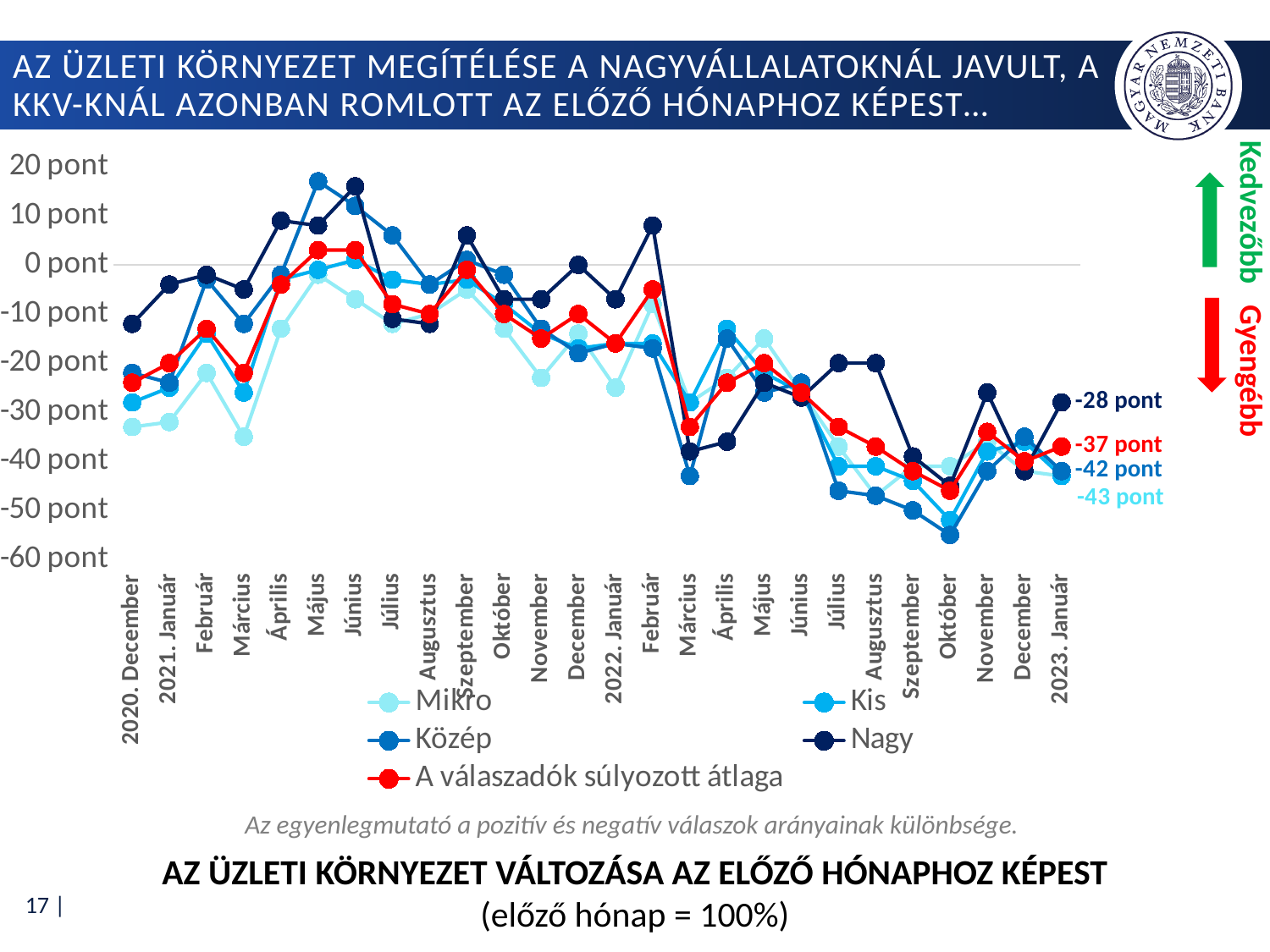
How many months (data points) are shown on the x axis? 26 What is the value for the Közép series in 2023. Január? -42 pont Which is larger in 2023. Január, the value for Nagy or the value for Kis? Nagy What is the value for the Kis series in 2023. Január? -43 pont Is the value for Nagy in 2022. Október greater or less than -50 pont? greater Is the value for Nagy in 2021. Június greater or less than 10 pont? greater What is the value for the Nagy series in 2023. Január? -28 pont Which series has the highest value in 2023. Január? Nagy What kind of chart is shown on the slide? line chart What is the value for 'A válaszadók súlyozott átlaga' in 2023. Január? -37 pont How many series does the legend list? 5 What is the difference between the Nagy value and the weighted average ('A válaszadók súlyozott átlaga') in 2023. Január? 9 pont